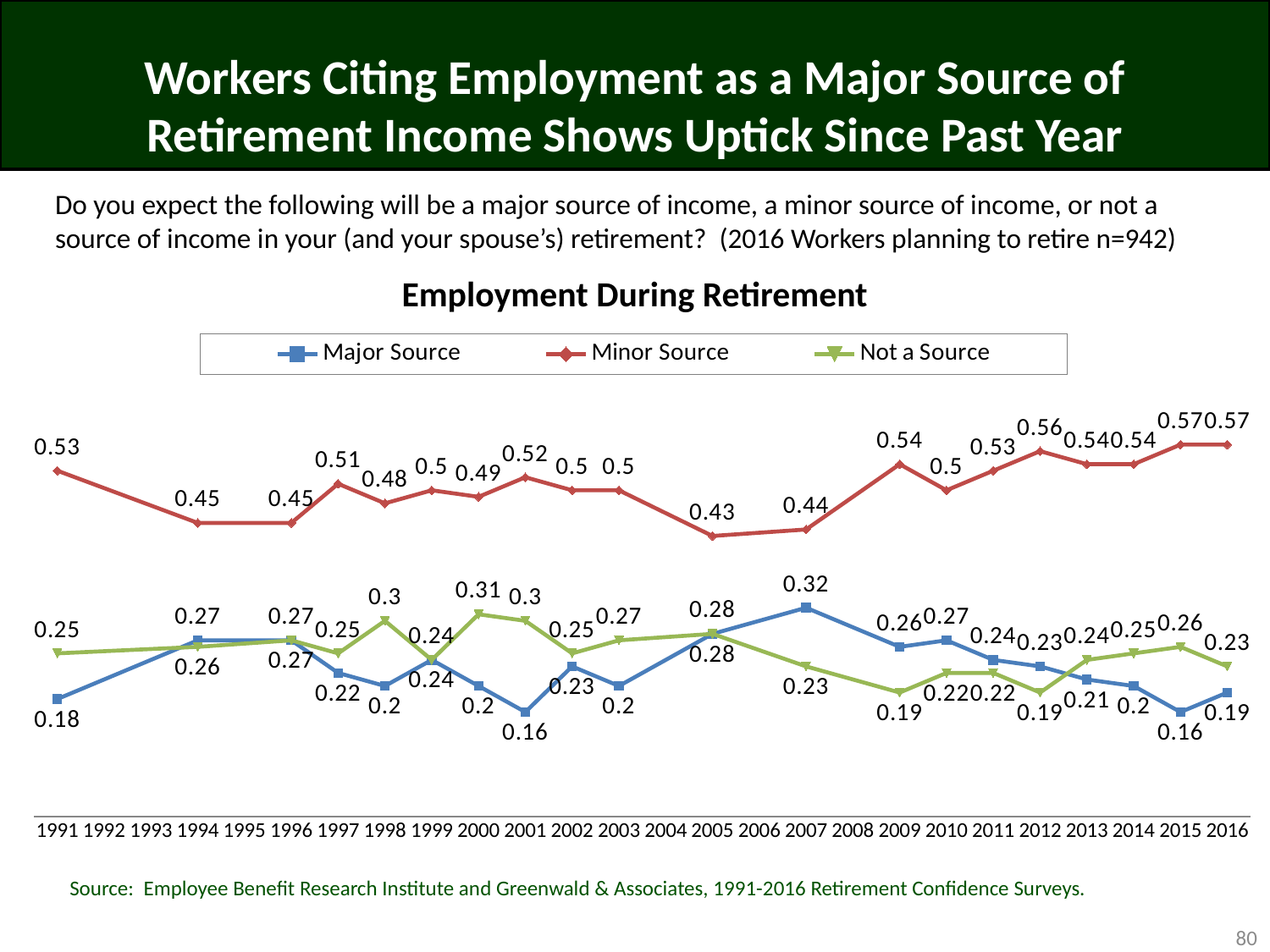
What is the value for Minor Source in 1991? 0.53 What is the value for Minor Source in 2016? 0.57 What is the value for Major Source in 2016? 0.19 What is the difference between the Minor Source and Major Source values in 2016? 0.38 How many series does the legend list? 3 In 1991, which is larger: the Minor Source value or the Not a Source value? Minor Source What is the value for Major Source in 1991? 0.18 What is the value for Not a Source in 1991? 0.25 What is the title of the chart? Employment During Retirement What type of chart is shown on the slide? Line chart What is the highest value reached by the Major Source series? 0.32 What is the lowest value reached by the Major Source series? 0.16